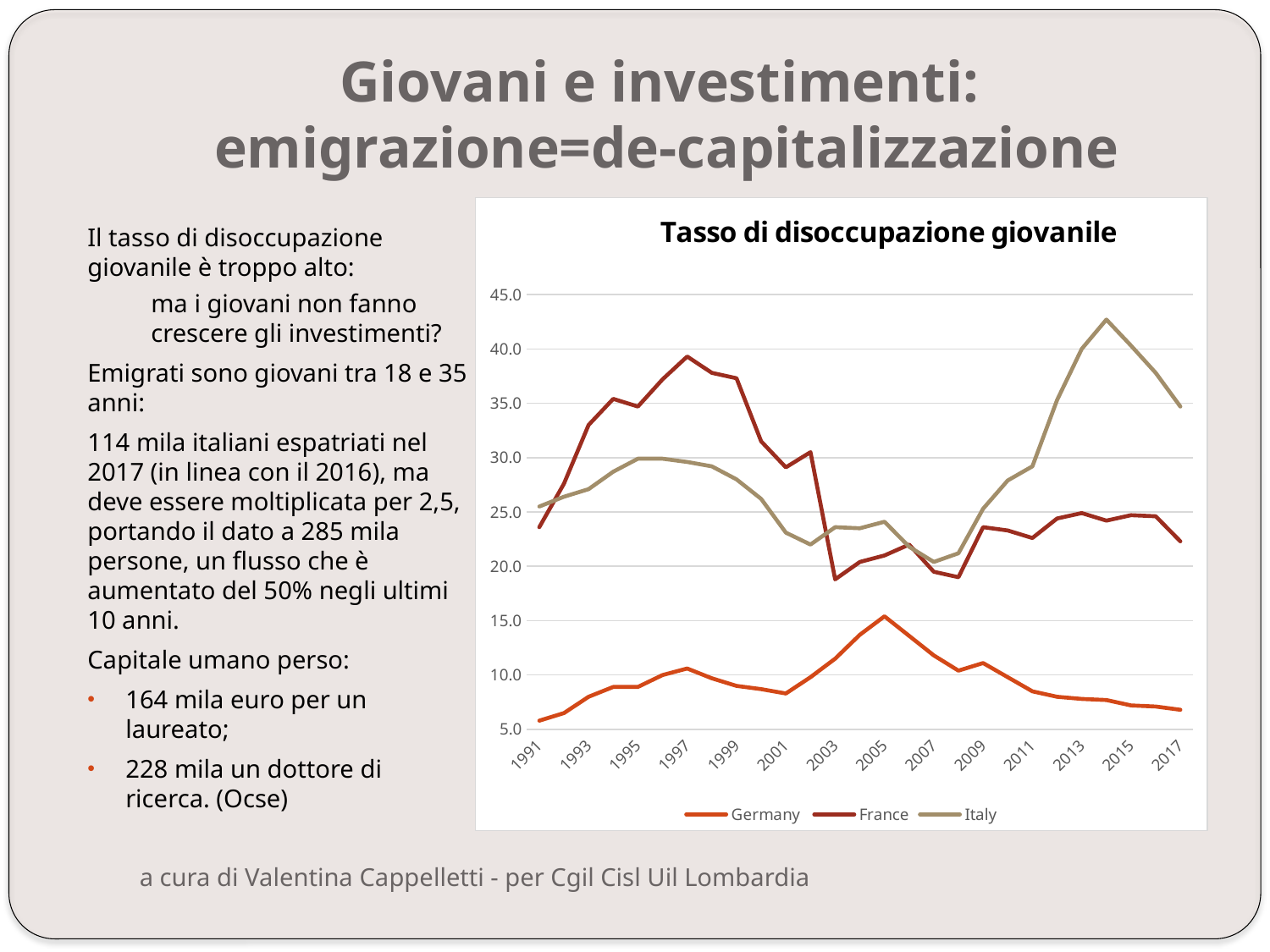
Which countries are listed in the chart's legend? Germany, France, Italy Is the value for Italy in 2017 greater or less than 30? greater What kind of chart is shown on the slide? Line chart Which series has the highest value in 2017? Italy What is the title of the chart? Tasso di disoccupazione giovanile Is the value for Germany in 2017 greater or less than 10? less Which series reaches the highest value anywhere on the chart? Italy How many series does the chart's legend list? 3 In 2005, which is larger, the value for Germany or the value for France? France Is the value for France in 1997 greater or less than 35? greater Which series has the lowest value in 2017? Germany Does the value for Germany rise or fall from 2005 to 2017? Fall